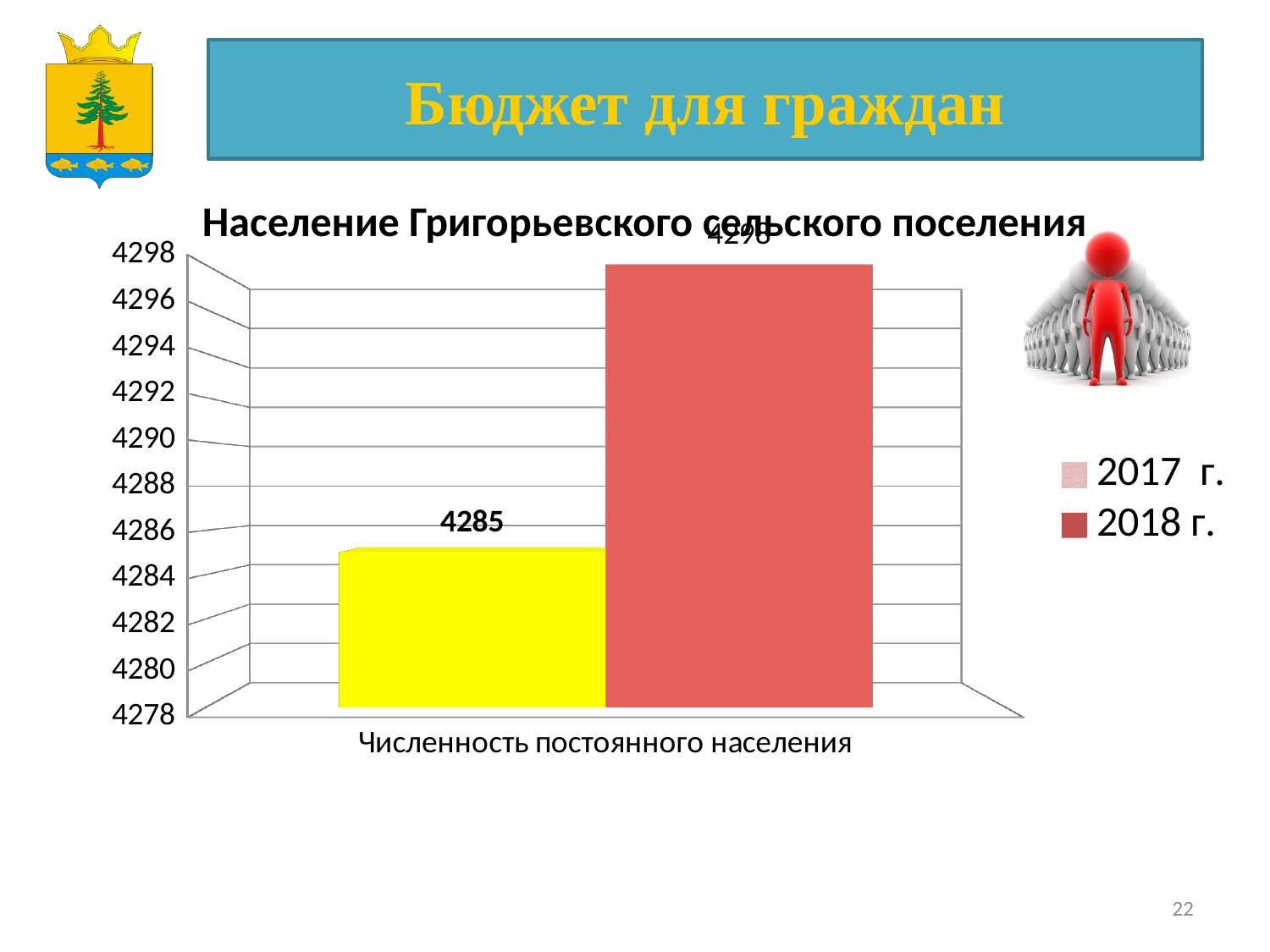
Did the population rise or fall from 2017 г. to 2018 г.? rise Which series shows the lowest population value? 2017 г. What is the category label on the x axis? Численность постоянного населения Is the value for 2017 г. greater or less than 4290? less What is the title of the chart? Население Григорьевского сельского поселения What kind of chart is shown on the slide? bar chart Which series has the higher value, 2017 г. or 2018 г.? 2018 г. What is the value for 2017 г. in the chart "Население Григорьевского сельского поселения"? 4285 Which series shows the highest population value? 2018 г. How many series does the legend list? 2 How many categories are shown on the x axis? 1 Is the value for 2018 г. greater or less than 4290? greater